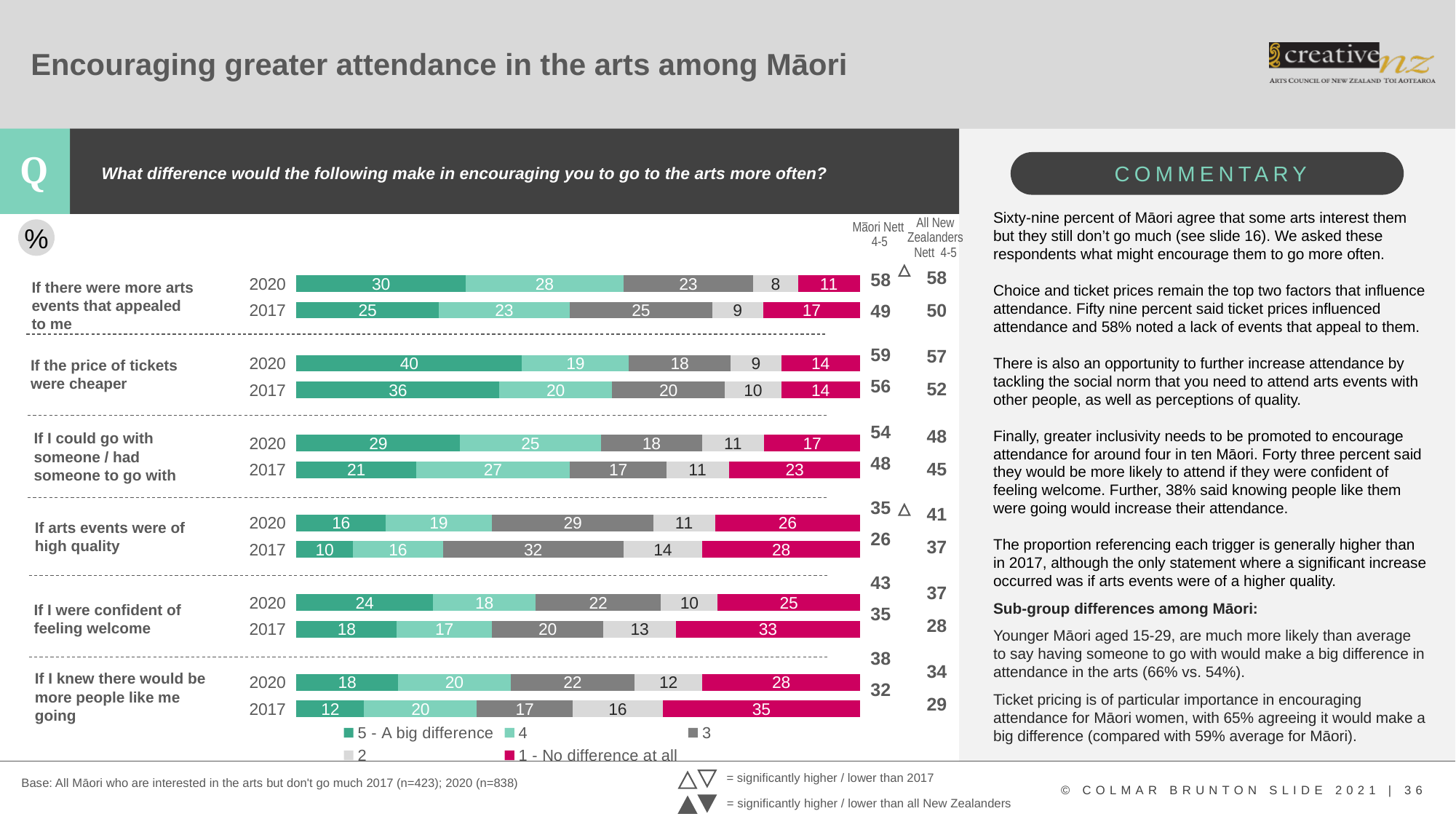
What is the total of the 2020 stacked bar for "If the price of tickets were cheaper"? 100 What is the value for "5 - A big difference" in the 2020 bar for "If the price of tickets were cheaper"? 40 How many series does the legend list? 5 Which statement has the highest "5 - A big difference" value in 2020? If the price of tickets were cheaper Which legend entry is shown in dark green? 5 - A big difference What is the value for "1 - No difference at all" in the 2017 bar for "If I knew there would be more people like me going"? 35 How many statements are shown in the chart? 6 For "If I could go with someone / had someone to go with", which year has the larger "1 - No difference at all" value, 2020 or 2017? 2017 What is the Māori Nett 4-5 value for "If I were confident of feeling welcome" in 2020? 43 What kind of chart is shown on the slide? Stacked bar chart Which statement has the lowest "5 - A big difference" value in 2017? If arts events were of high quality For "If there were more arts events that appealed to me", how much higher is the "5 - A big difference" value in 2020 than in 2017? 5